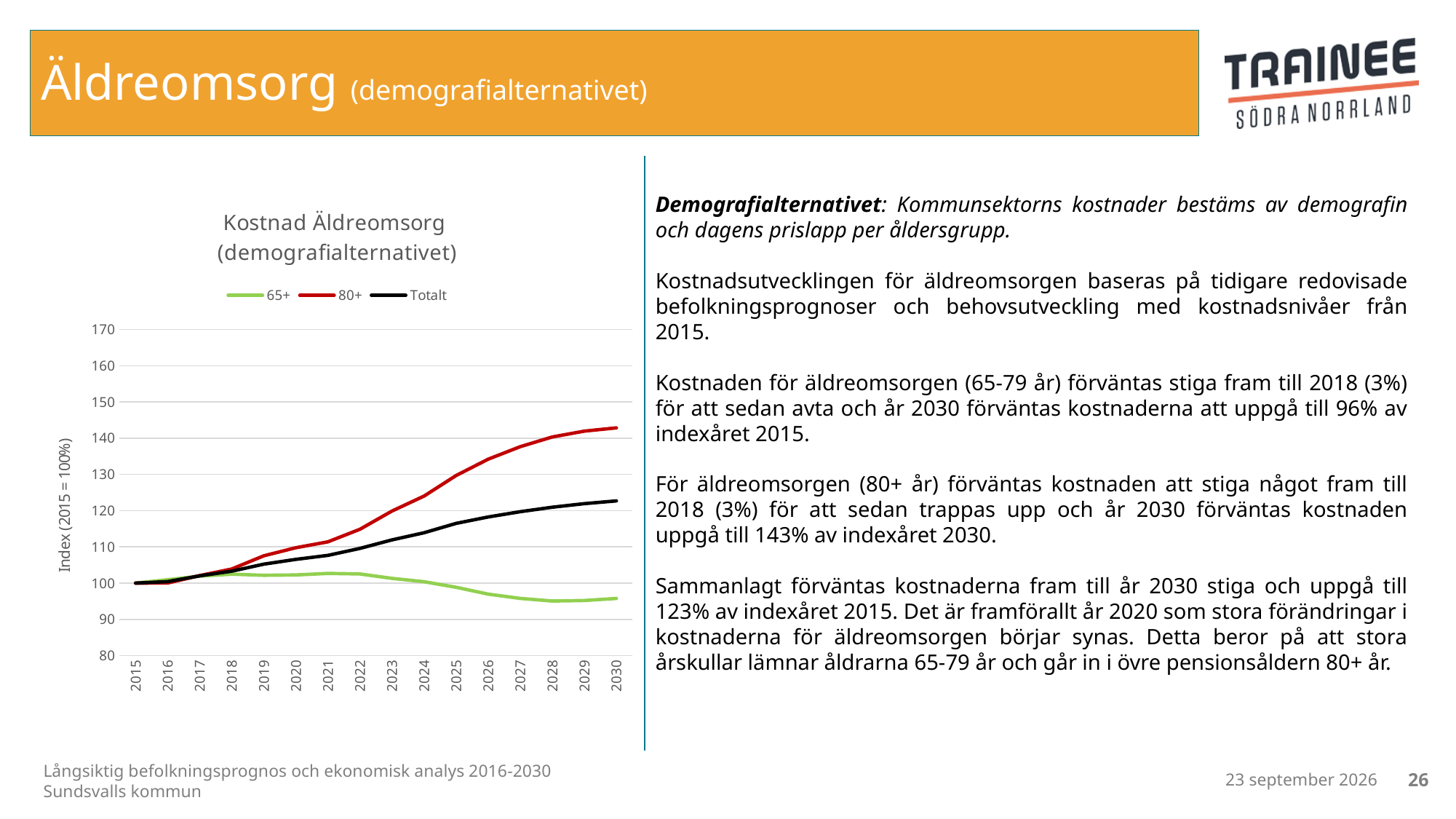
Which series has the lowest value in 2030? 65+ Is the value for the Totalt series in 2030 greater or less than 120? greater What kind of chart is shown on the slide? line chart Does the 65+ series rise or fall between 2022 and 2030? fall How many years are plotted along the x axis of the chart? 16 What is the index value of the Totalt series in 2015? 100 What is the label on the y axis of the chart? Index (2015 = 100%) Is the value for the 65+ series in 2030 greater or less than 100? less In 2030, which is larger: the 80+ series or the Totalt series? 80+ How many series does the legend of the chart list? 3 Which series has the highest value in 2030? 80+ Is the value for the 80+ series in 2030 greater or less than 140? greater